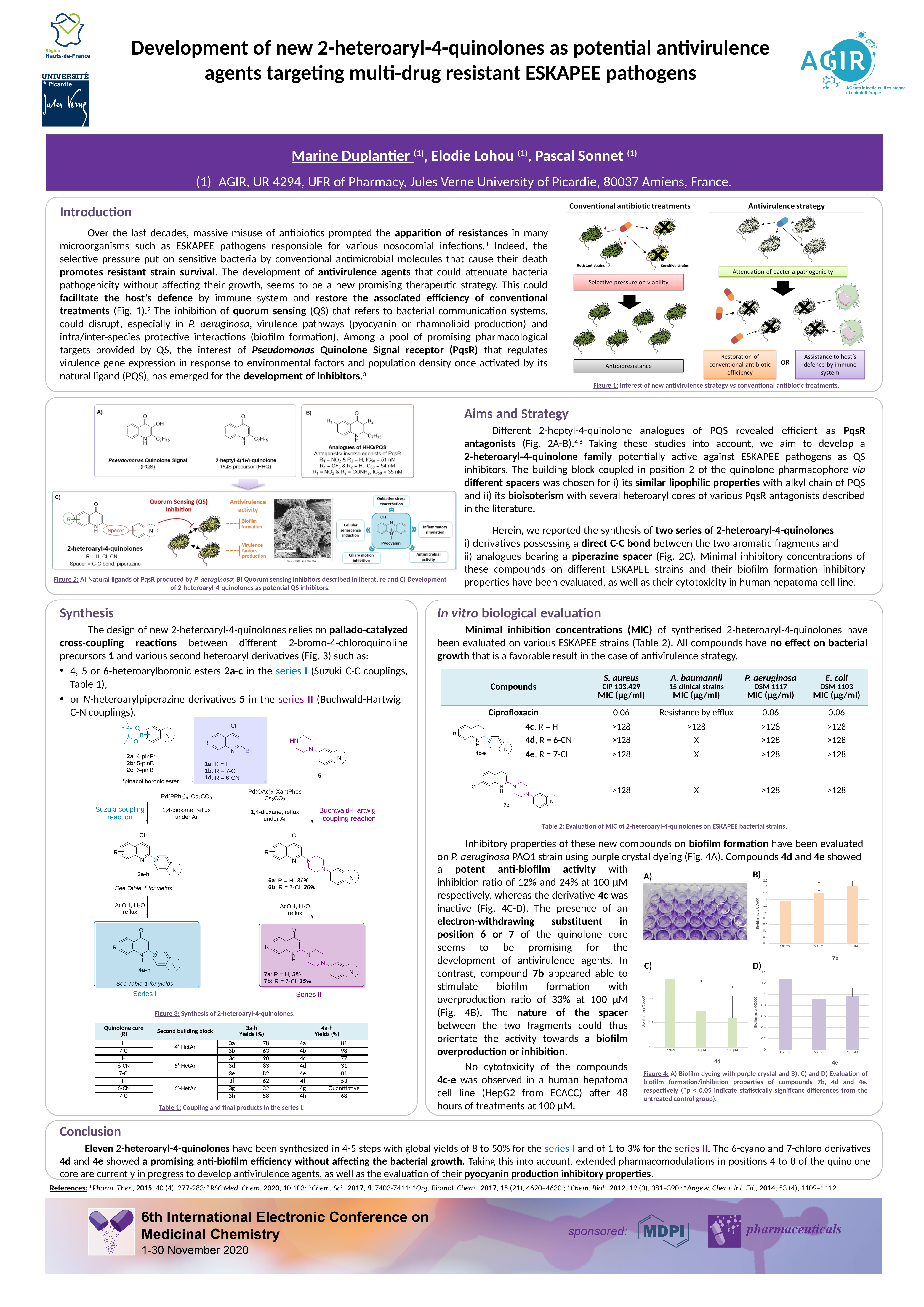
In Figure 4B (compound 7b), is the value for 100 µM greater or less than 1.6? greater In Figure 4B (compound 7b), how many bars are plotted? 3 In Figure 4C (compound 4d), is the value for 100 µM greater or less than 1.2? less In Figure 4B (compound 7b), which condition has the highest biofilm mass? 100 µM In Figure 4D (compound 4e), what is the label of the y axis? Biofilm mass OD600 In Figure 4D (compound 4e), which is larger, the Control bar or the 50 µM bar? Control In Figure 4B (compound 7b), what kind of chart is shown? bar chart In Figure 4C (compound 4d), which condition has the highest biofilm mass? Control In Figure 4D (compound 4e), is the value for Control greater or less than 1.0? greater In Figure 4B (compound 7b), do the bar values rise or fall from Control to 100 µM? rise In Figure 4B (compound 7b), which condition has the lowest biofilm mass? Control In Figure 4C (compound 4d), do the bar values rise or fall from Control to 100 µM? fall